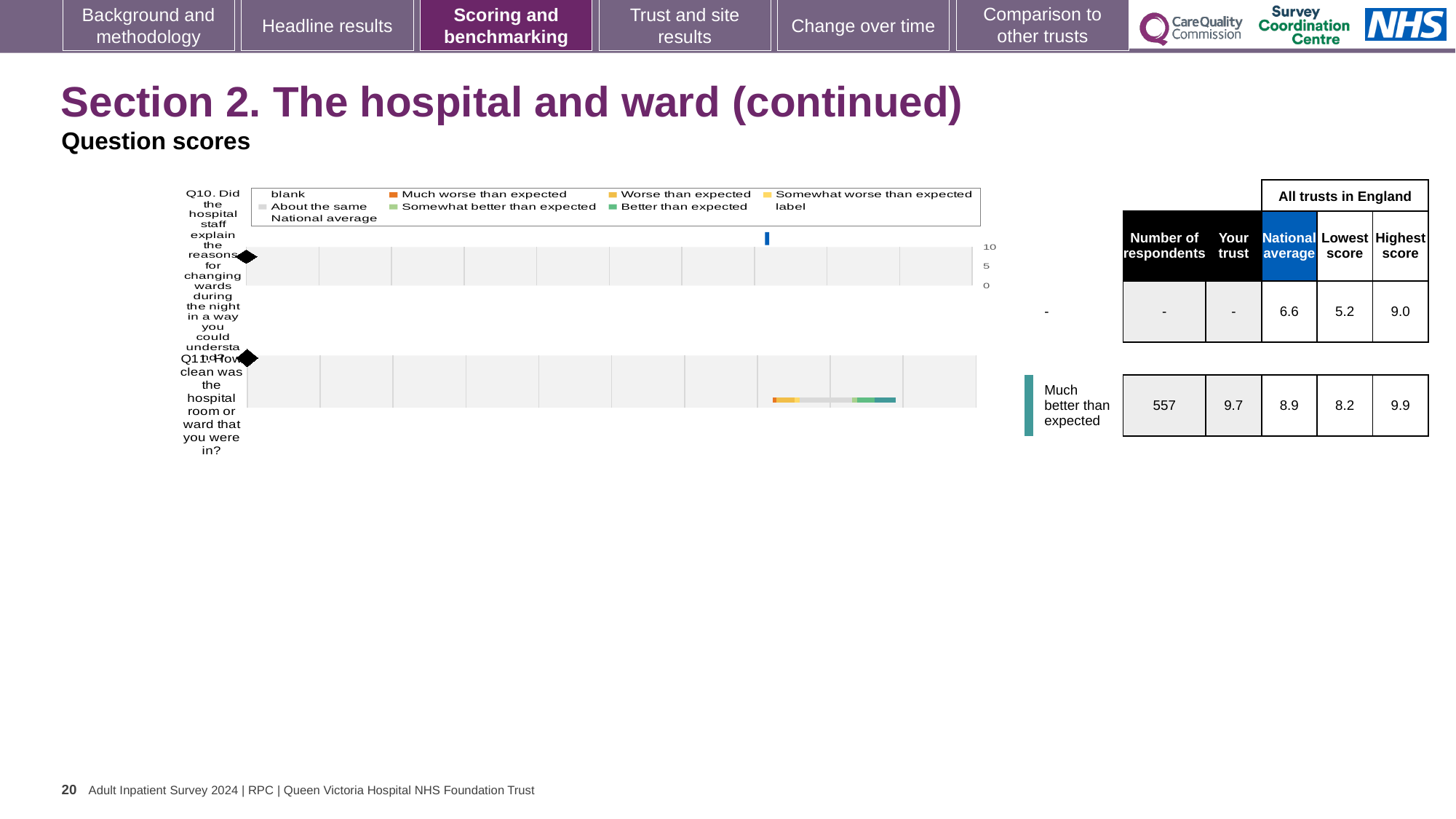
In the table beside the chart, what is the national average for Q11? 8.9 What kind of chart is shown on the slide? Bar chart In the table beside the chart, what is the 'Your trust' score for Q11? 9.7 In the table beside the chart, what is the national average for Q10 (Did the hospital staff explain the reasons for changing wards during the night)? 6.6 What benchmark category is shown next to Q11 on the slide? Much better than expected In the table beside the chart, what is the number of respondents for Q11 (How clean was the hospital room or ward that you were in?)? 557 What is the difference between the highest score (9.9) and the lowest score (8.2) for Q11 in the table? 1.7 By how much does the 'Your trust' score (9.7) exceed the national average (8.9) for Q11? 0.8 For Q11, which is larger in the table: the 'Your trust' score or the national average? Your trust In the table beside the chart, what is the lowest score across all trusts in England for Q10? 5.2 How many survey questions are plotted on the chart? 2 What is the highest tick value shown on the chart's horizontal axis? 10